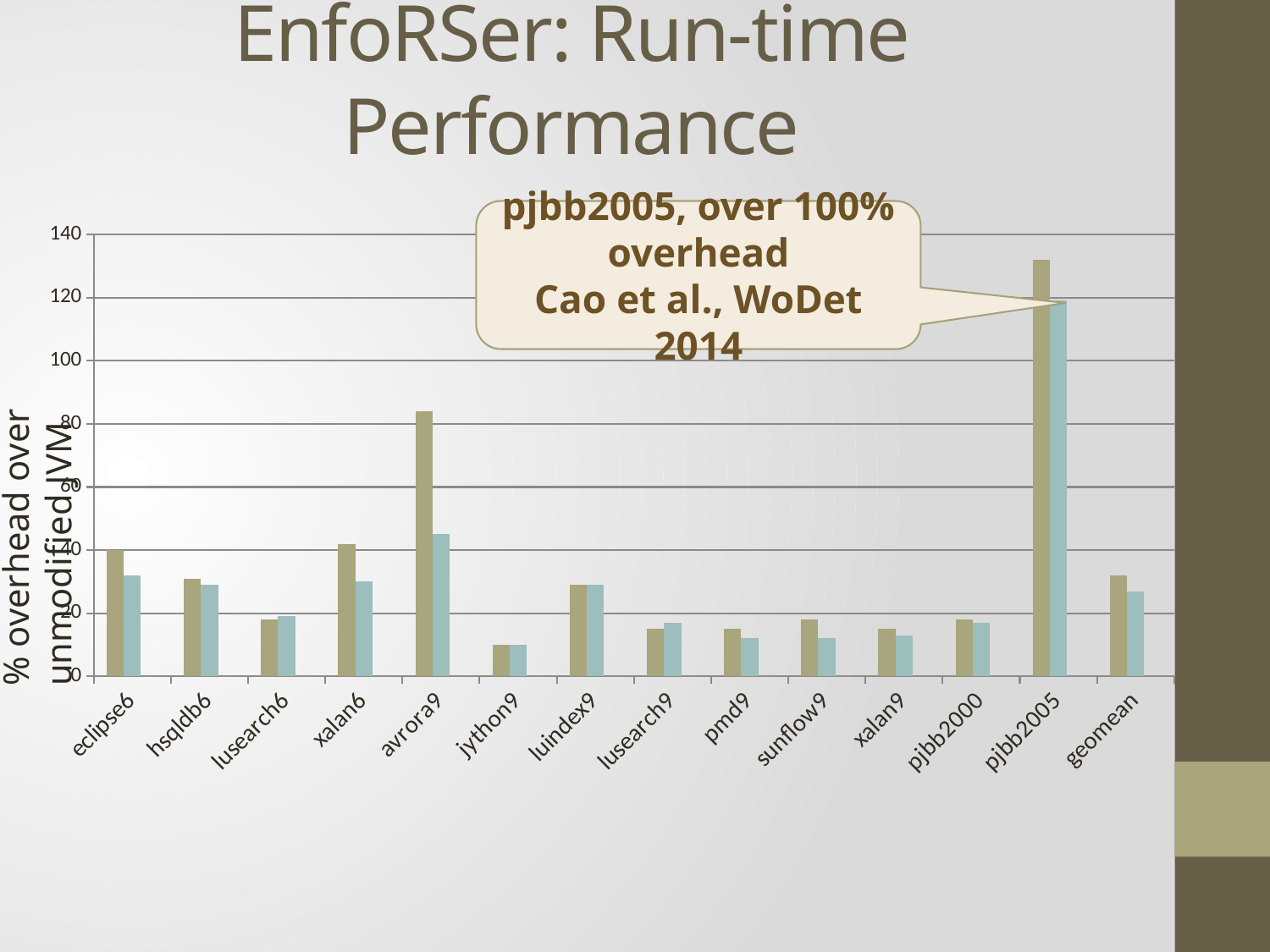
What does the callout on the chart say about pjbb2005? pjbb2005, over 100% overhead Cao et al., WoDet 2014 Is the value for jython9 greater or less than 20? less What is the label on the y axis? % overhead over unmodified JVM Which has the larger overhead, pjbb2005 or avrora9? pjbb2005 Which category has the highest overhead? pjbb2005 Which category has the lowest overhead? jython9 Is the value of the left bar for geomean greater or less than 40? less Is the value of the left bar for avrora9 greater or less than 60? greater What kind of chart is shown on the slide? bar chart Which has the larger overhead, avrora9 or xalan6? avrora9 How many benchmark categories are shown on the x axis? 14